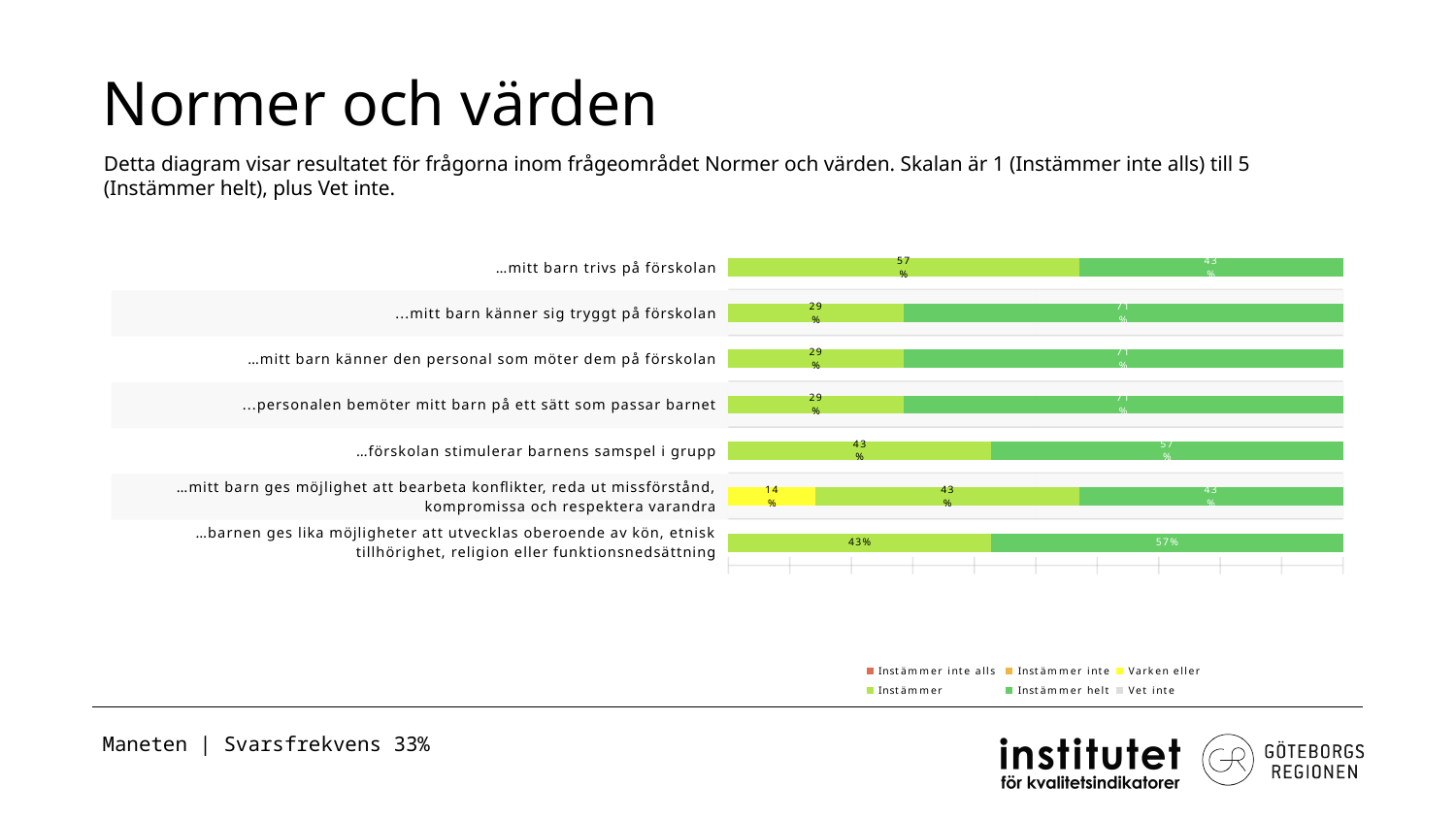
How many categories (questions) are plotted in the chart? 7 Which legend entry is shown in yellow? Varken eller What is the difference between the 'Instämmer helt' and 'Instämmer' values for '…förskolan stimulerar barnens samspel i grupp'? 14% What is the 'Instämmer helt' value for '…mitt barn trivs på förskolan'? 43% How many series does the legend list? 6 What is the 'Instämmer' value for '…barnen ges lika möjligheter att utvecklas oberoende av kön, etnisk tillhörighet, religion eller funktionsnedsättning'? 43% Which category has the highest 'Instämmer' value? …mitt barn trivs på förskolan What is the 'Varken eller' value for '…mitt barn ges möjlighet att bearbeta konflikter, reda ut missförstånd, kompromissa och respektera varandra'? 14% What kind of chart is shown on the slide? stacked bar chart What is the 'Instämmer' value for '…mitt barn känner sig tryggt på förskolan'? 29% Which is larger for '…mitt barn trivs på förskolan': the 'Instämmer' value or the 'Instämmer helt' value? Instämmer What is the 'Instämmer helt' value for '…personalen bemöter mitt barn på ett sätt som passar barnet'? 71%